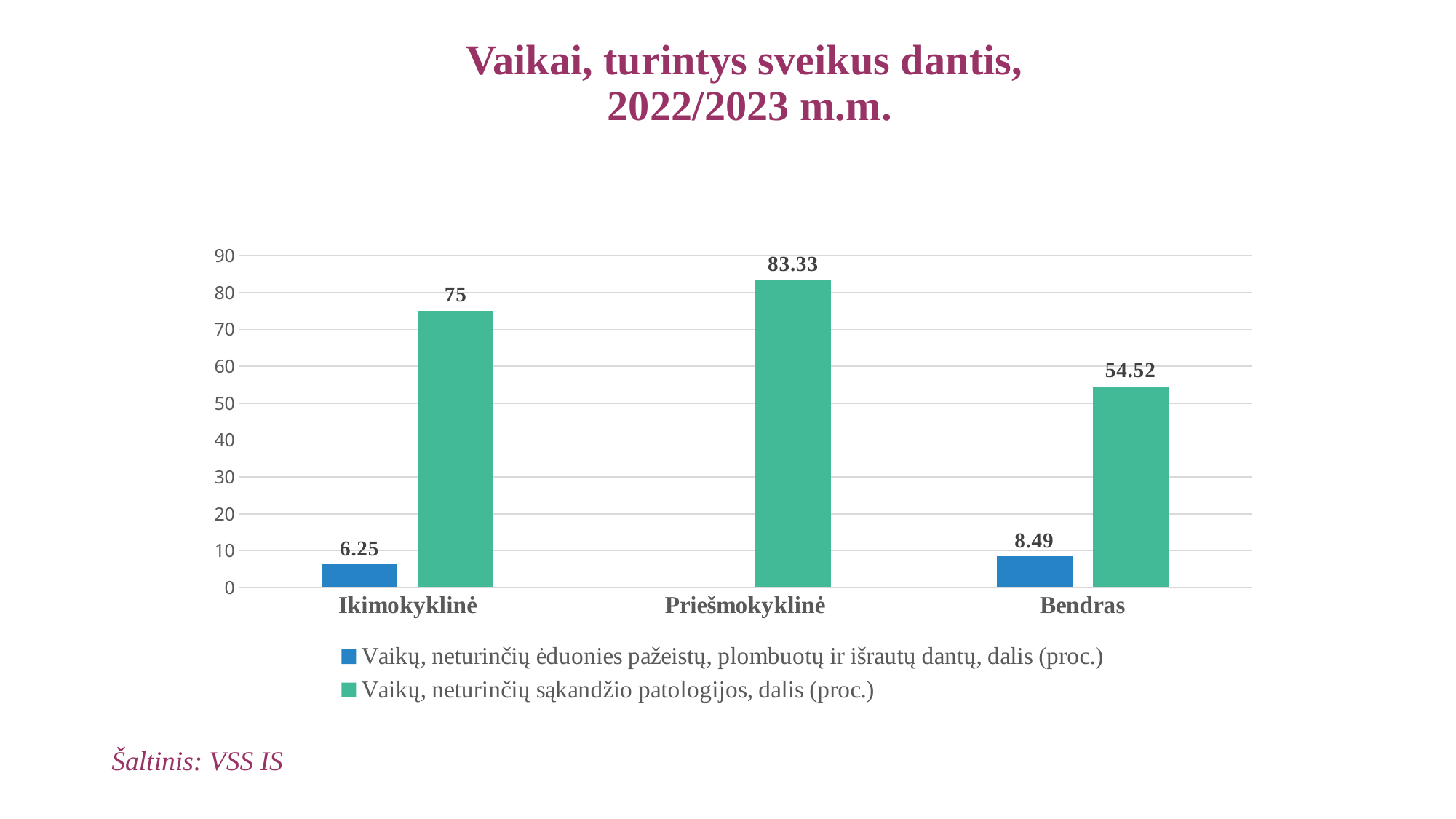
What kind of chart is shown on the slide? Bar chart Which category has the lowest value in the green series (Vaikų, neturinčių sąkandžio patologijos)? Bendras What is the value of the blue series (Vaikų, neturinčių ėduonies pažeistų, plombuotų ir išrautų dantų, dalis (proc.)) for Ikimokyklinė? 6.25 What is the value of the green series for Bendras? 54.52 Which category has the highest value in the green series (Vaikų, neturinčių sąkandžio patologijos)? Priešmokyklinė What is the title of the chart? Vaikai, turintys sveikus dantis, 2022/2023 m.m. How many categories are shown on the x axis? 3 What is the value of the green series (Vaikų, neturinčių sąkandžio patologijos, dalis (proc.)) for Priešmokyklinė? 83.33 What is the difference between the green series values for Priešmokyklinė and Ikimokyklinė? 8.33 What is the value of the blue series for Bendras? 8.49 How many series does the legend list? 2 Which is larger: the blue series value for Bendras or for Ikimokyklinė? Bendras